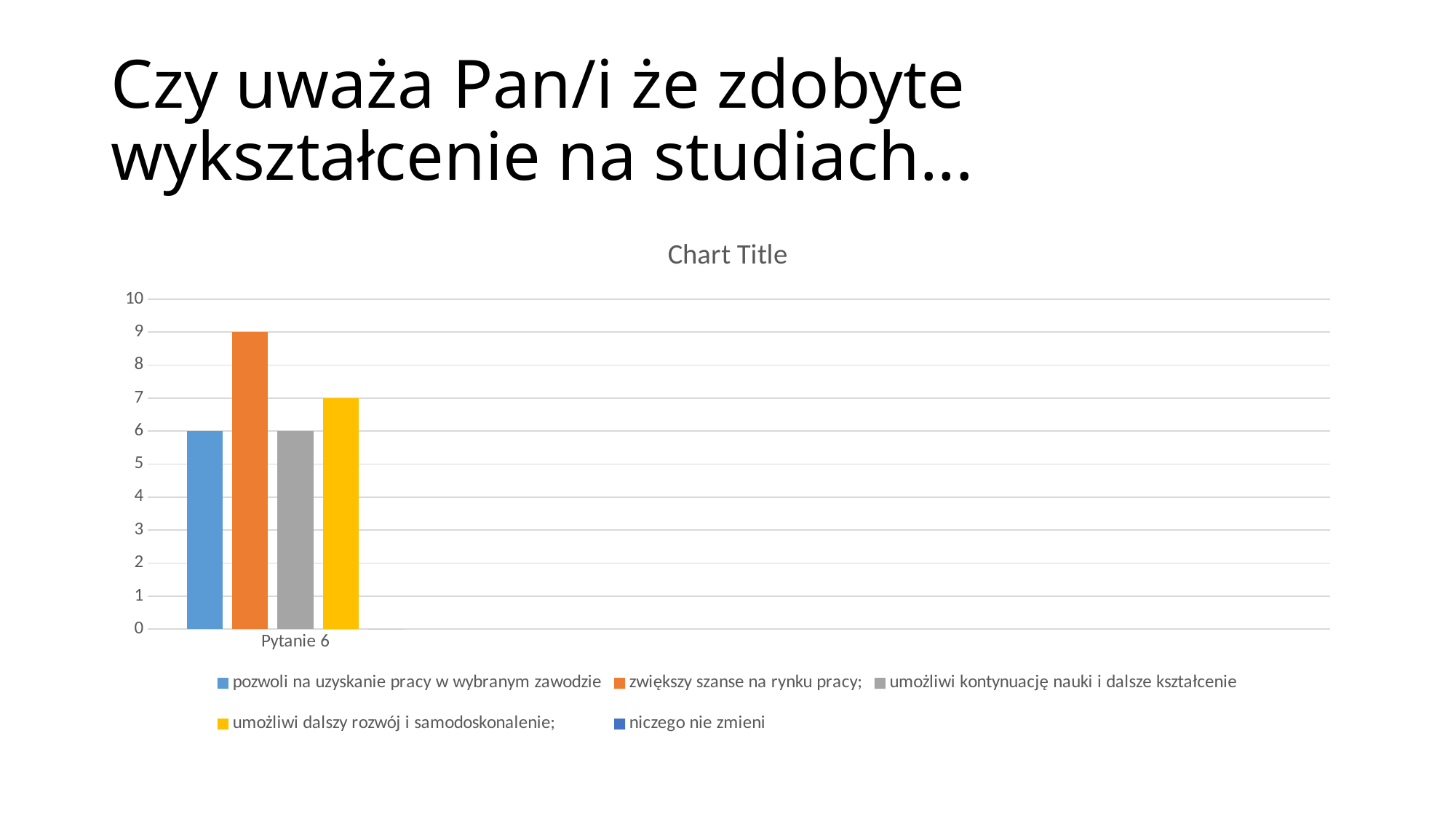
How many series does the legend list? 5 What is the value for "zwiększy szanse na rynku pracy;" for Pytanie 6? 9 What is the value for "umożliwi kontynuację nauki i dalsze kształcenie" for Pytanie 6? 6 What is the value for "pozwoli na uzyskanie pracy w wybranym zawodzie" for Pytanie 6? 6 Is the value for "zwiększy szanse na rynku pracy;" greater or less than 8? greater Which is larger: the value for "umożliwi dalszy rozwój i samodoskonalenie;" or the value for "pozwoli na uzyskanie pracy w wybranym zawodzie"? umożliwi dalszy rozwój i samodoskonalenie; What kind of chart is shown on the slide? bar chart What colour is the bar for "zwiększy szanse na rynku pracy;"? orange What is the value for "umożliwi dalszy rozwój i samodoskonalenie;" for Pytanie 6? 7 What is the difference between the values for "zwiększy szanse na rynku pracy;" and "umożliwi dalszy rozwój i samodoskonalenie;"? 2 How many categories are shown on the x axis? 1 Which series has the highest value for Pytanie 6? zwiększy szanse na rynku pracy;